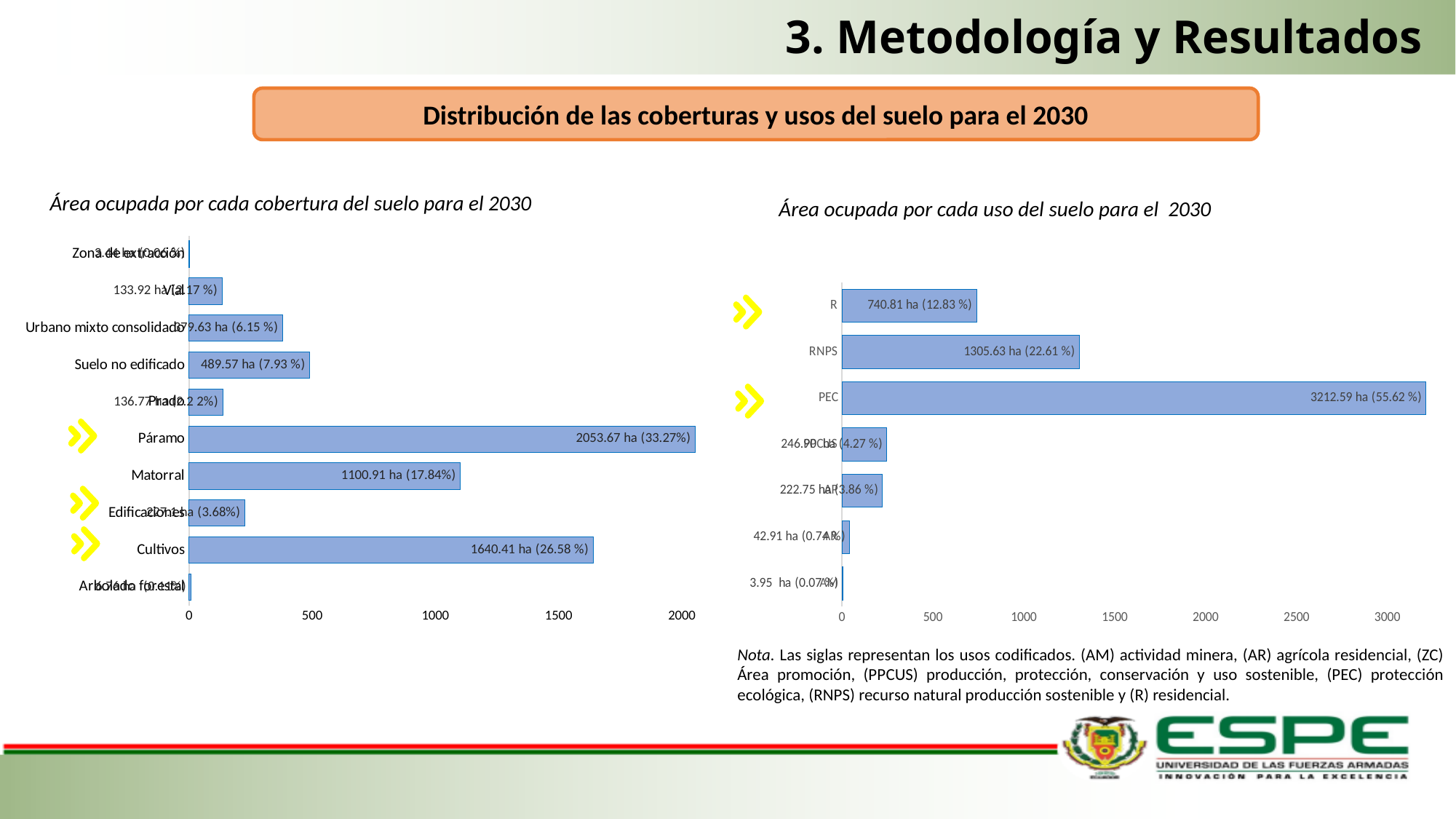
In the chart 'Área ocupada por cada cobertura del suelo para el 2030', what is the data label for Matorral? 1100.91 ha (17.84%) In the chart 'Área ocupada por cada cobertura del suelo para el 2030', what is the data label for Páramo? 2053.67 ha (33.27%) In the chart 'Área ocupada por cada cobertura del suelo para el 2030', what is the data label for Cultivos? 1640.41 ha (26.58 %) In the chart 'Área ocupada por cada cobertura del suelo para el 2030', how many categories are plotted? 10 In the chart 'Área ocupada por cada uso del suelo para el 2030', what is the data label for RNPS? 1305.63 ha (22.61 %) What type of chart is 'Área ocupada por cada uso del suelo para el 2030'? Bar chart In the chart 'Área ocupada por cada cobertura del suelo para el 2030', which category has the largest area? Páramo In the chart 'Área ocupada por cada uso del suelo para el 2030', what is the data label for PEC? 3212.59 ha (55.62 %) In the chart 'Área ocupada por cada uso del suelo para el 2030', is the value for R greater or less than 500? greater In the chart 'Área ocupada por cada uso del suelo para el 2030', which use has the largest area? PEC In the chart 'Área ocupada por cada cobertura del suelo para el 2030', is the value for Suelo no edificado greater or less than 500? less In the chart 'Área ocupada por cada cobertura del suelo para el 2030', which is larger, Matorral or Cultivos? Cultivos